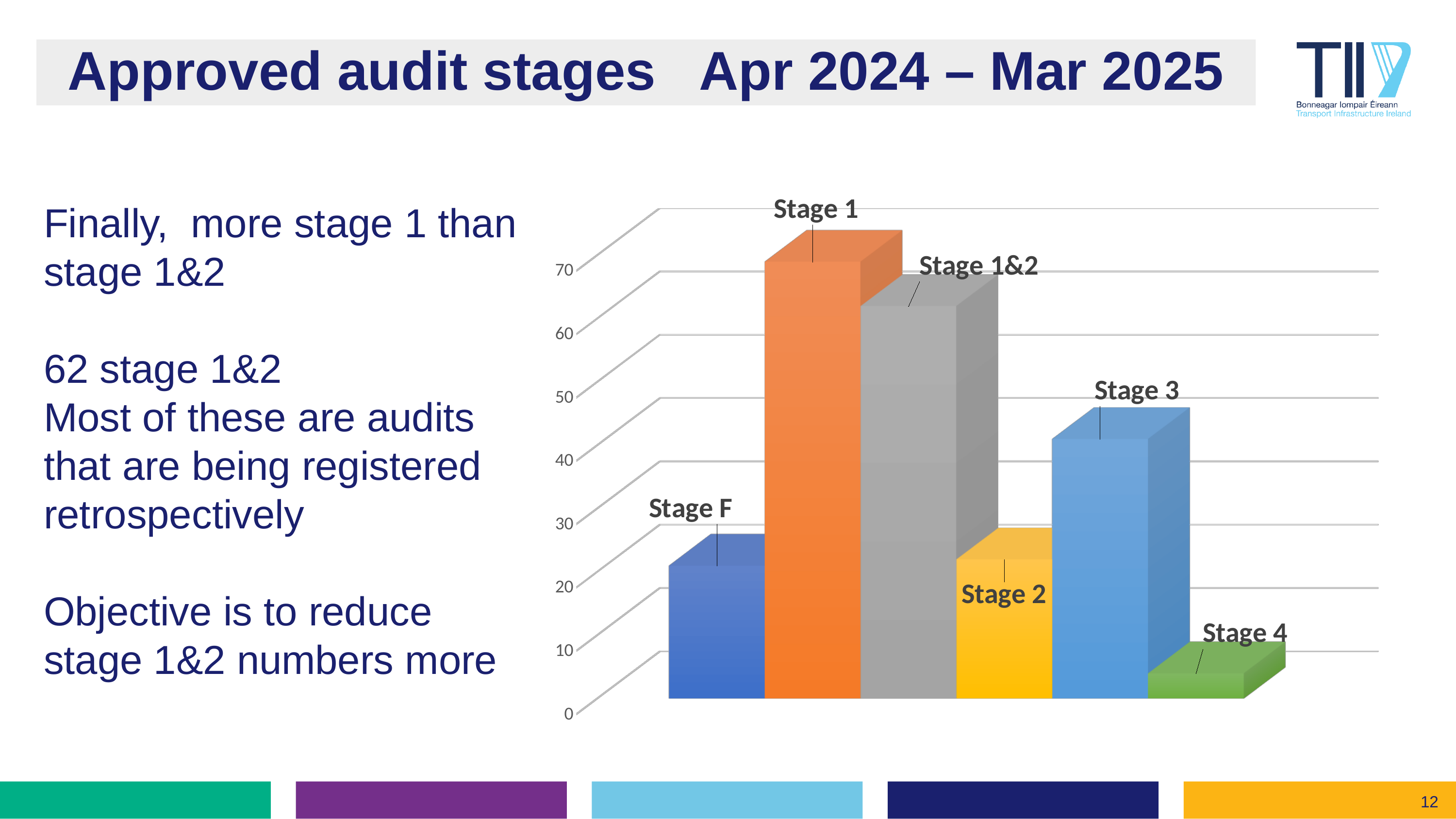
Is the value for Stage 4 greater or less than 10? less Is the value for Stage 3 greater or less than 50? less What kind of chart is shown on the slide? bar chart How many stage categories are plotted in the chart? 6 Which stage has the highest bar in the chart? Stage 1 Is the value for Stage F greater or less than 30? less Which is larger, the value for Stage 3 or the value for Stage 4? Stage 3 What colour is the bar for Stage 1? orange Which is larger, the value for Stage 1 or the value for Stage 1&2? Stage 1 Which stage has the lowest bar in the chart? Stage 4